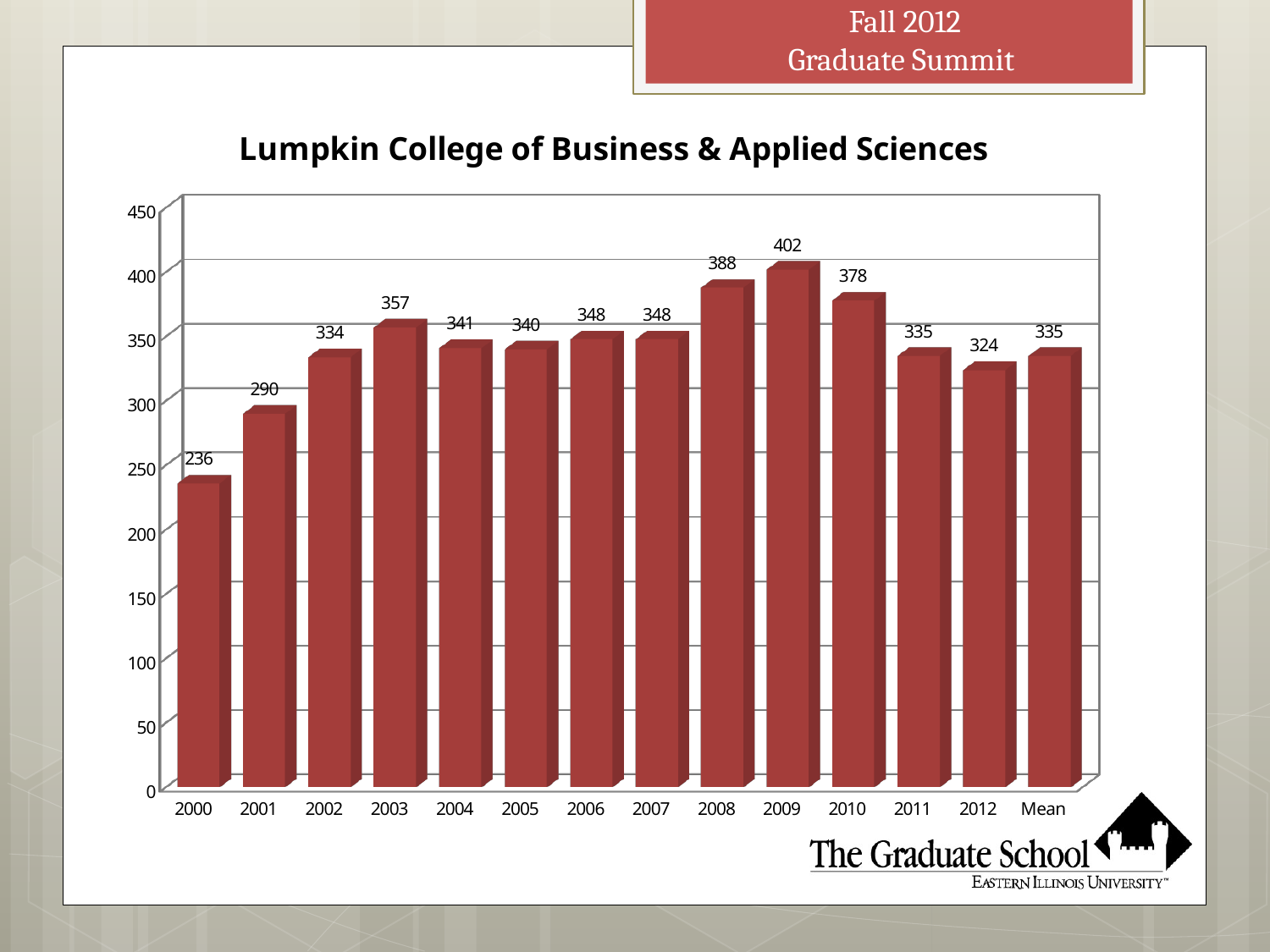
Which category has the lowest value? 2000 What kind of chart is shown on the slide? bar chart Which is larger, the value for 2008 or the value for 2010? 2008 Which category has the highest value? 2009 Do the values rise or fall from 2000 to 2003? rise What is the value for 2000? 236 What is the title of the chart? Lumpkin College of Business & Applied Sciences What is the value shown for Mean? 335 What is the difference between the values for 2009 and 2012? 78 Is the value for 2001 greater or less than 300? less How many bars are shown in the chart? 14 What is the value for 2009? 402